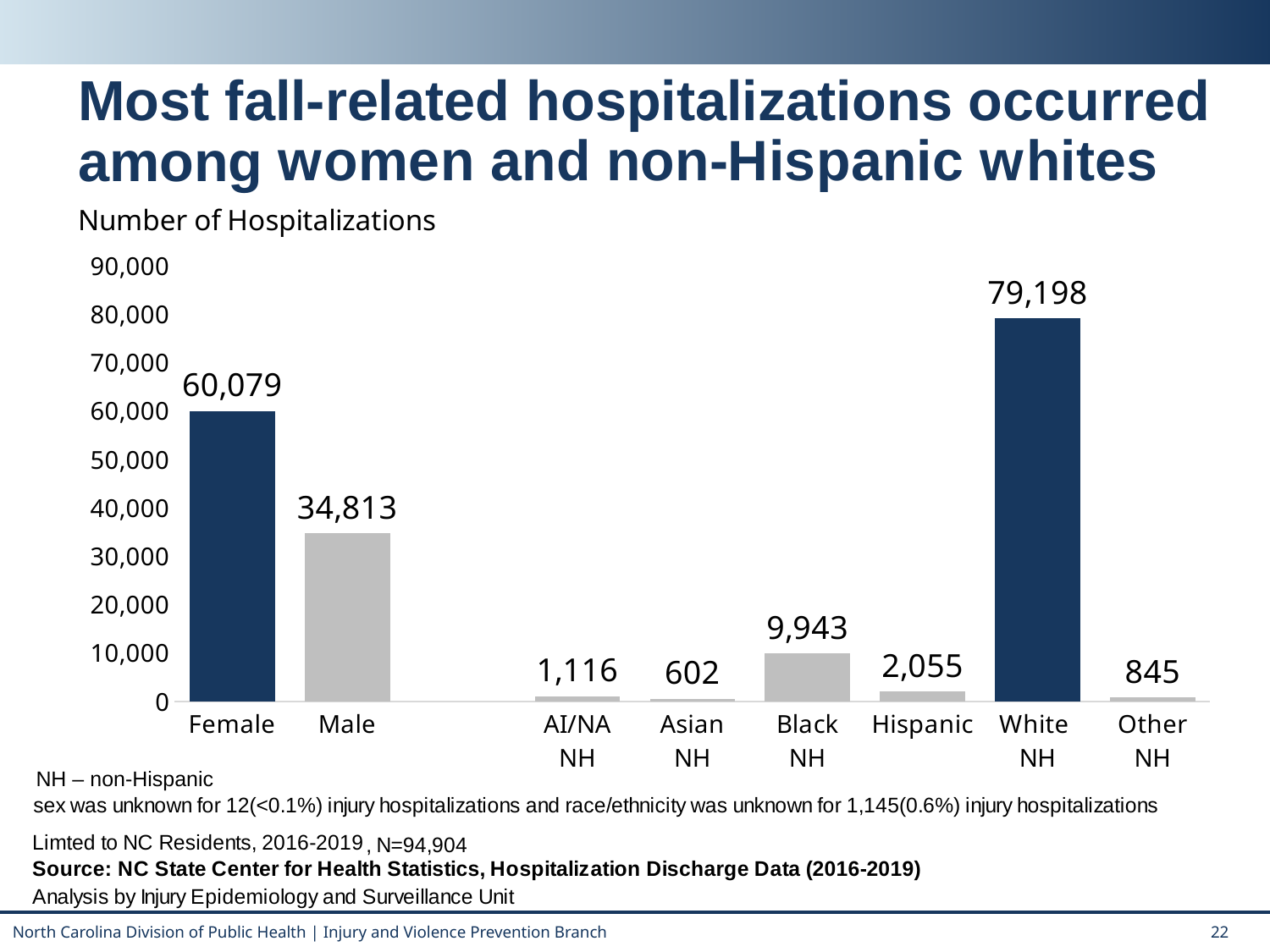
Which has more hospitalizations, Hispanic or AI/NA NH? Hispanic What is the number of hospitalizations for Black NH? 9,943 Which category has the highest number of hospitalizations? White NH Is the value for Male greater or less than 30,000? greater What kind of chart is shown on the slide? bar chart What is the difference in hospitalizations between White NH and Black NH? 69,255 Which category has the lowest number of hospitalizations? Asian NH What is the number of hospitalizations for Female? 60,079 How many categories are shown on the x axis of the chart? 8 What is the difference in hospitalizations between Female and Male? 25,266 What is the number of hospitalizations for Hispanic? 2,055 What is the number of hospitalizations for White NH? 79,198